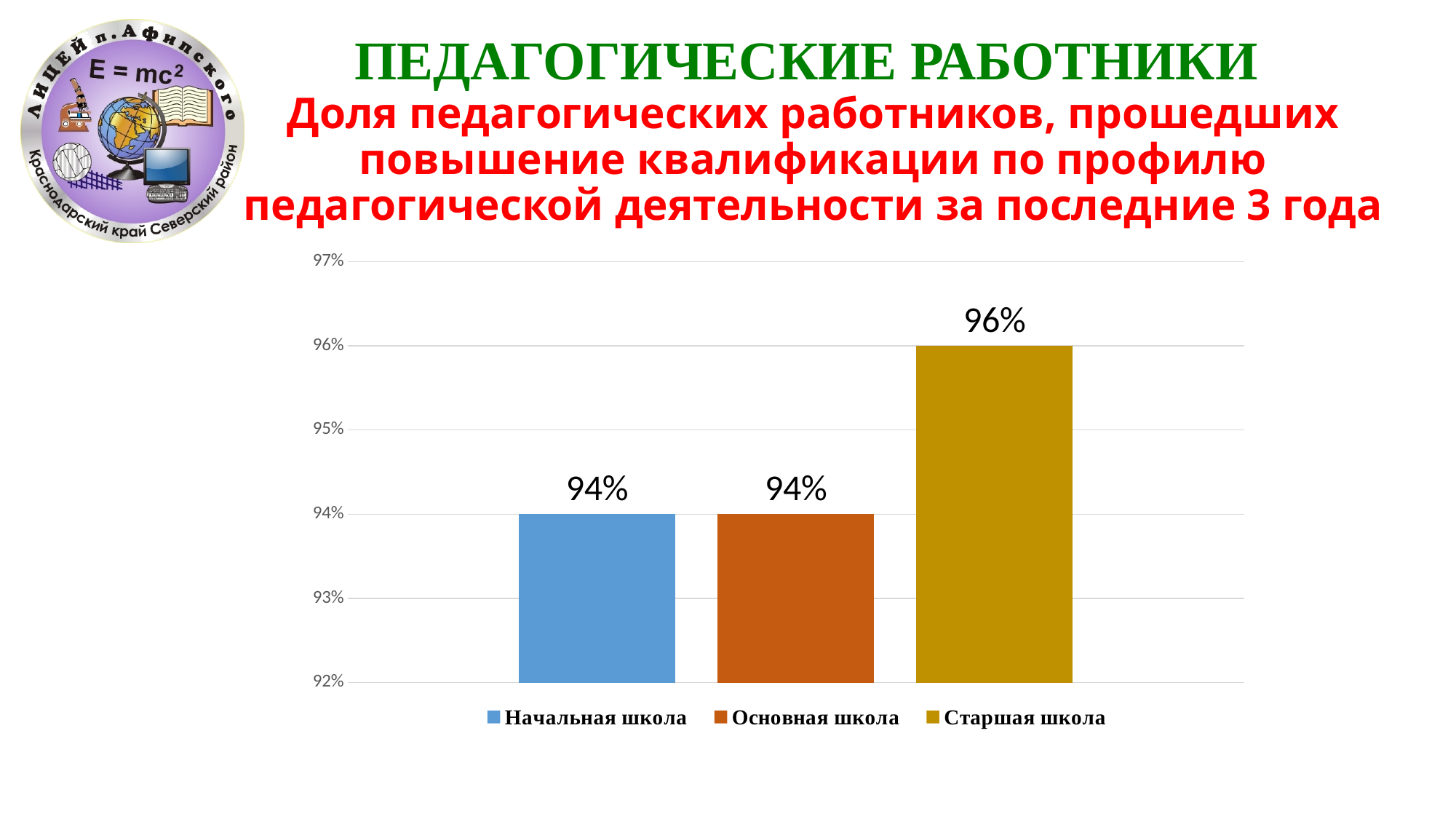
Which is larger, the value for Старшая школа or the value for Основная школа? Старшая школа Which category has the highest value? Старшая школа How many bars are plotted in the chart? 3 Is the value for Старшая школа greater or less than 95%? greater What kind of chart is shown on the slide? bar chart What is the value for Основная школа? 94% What colour is the bar for Старшая школа? gold What is the difference between the values for Старшая школа and Начальная школа? 2% What is the value for Начальная школа? 94% How many entries does the legend list? 3 What is the value for Старшая школа? 96% Is the value for Начальная школа greater or less than 95%? less